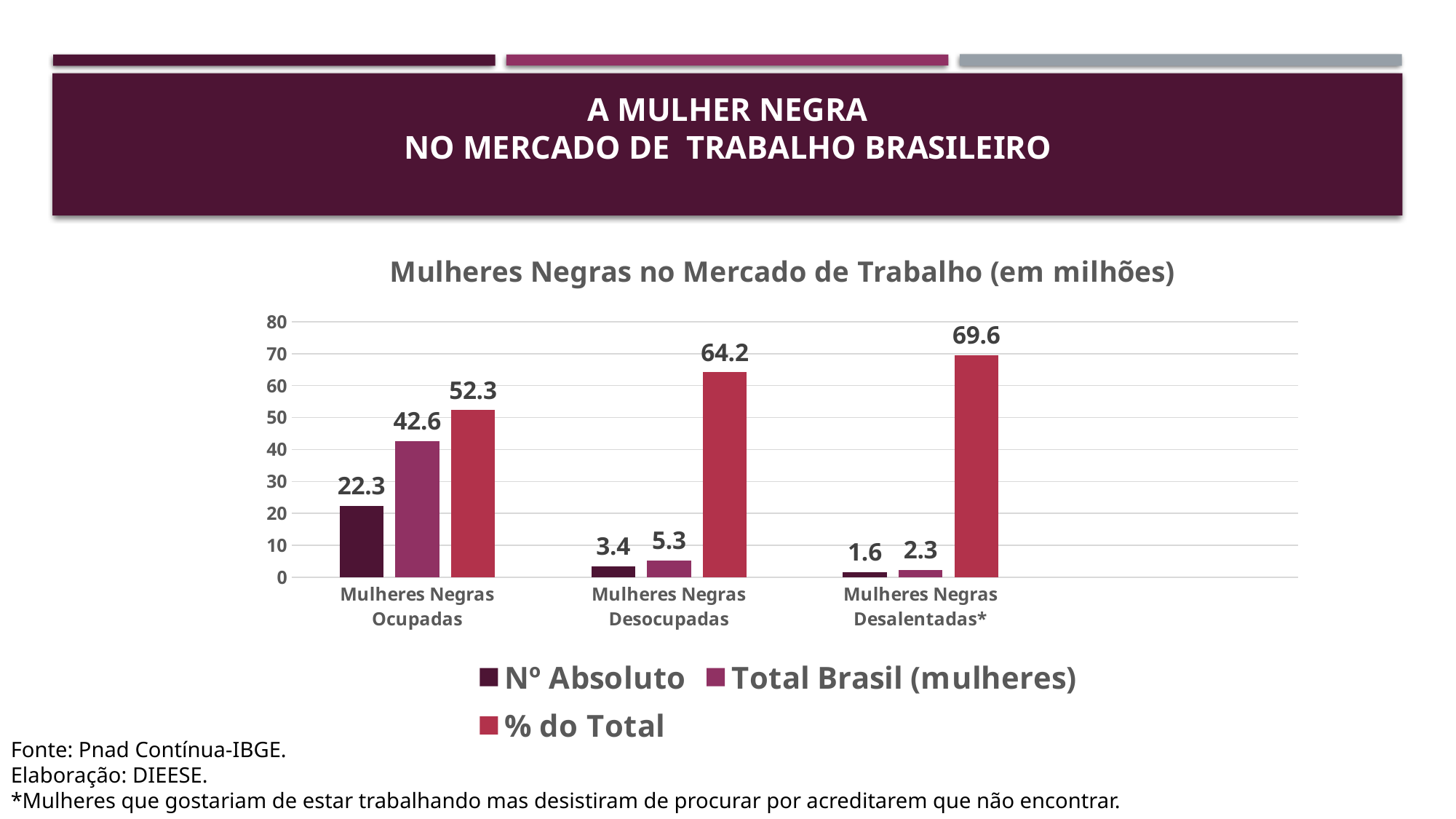
Which category has the highest % do Total value? Mulheres Negras Desalentadas* What is the value of Nº Absoluto for Mulheres Negras Ocupadas? 22.3 How many series does the legend list? 3 What is the difference between Total Brasil (mulheres) and Nº Absoluto for Mulheres Negras Ocupadas? 20.3 What is the title of the chart? Mulheres Negras no Mercado de Trabalho (em milhões) How many categories are shown on the x axis? 3 Which is larger: the % do Total for Mulheres Negras Ocupadas or for Mulheres Negras Desocupadas? Mulheres Negras Desocupadas Which category has the lowest Nº Absoluto value? Mulheres Negras Desalentadas* What kind of chart is shown on the slide? Bar chart What is the % do Total value for Mulheres Negras Desalentadas*? 69.6 Is the Total Brasil (mulheres) value for Mulheres Negras Ocupadas greater or less than 40? greater What is the value of Total Brasil (mulheres) for Mulheres Negras Desocupadas? 5.3